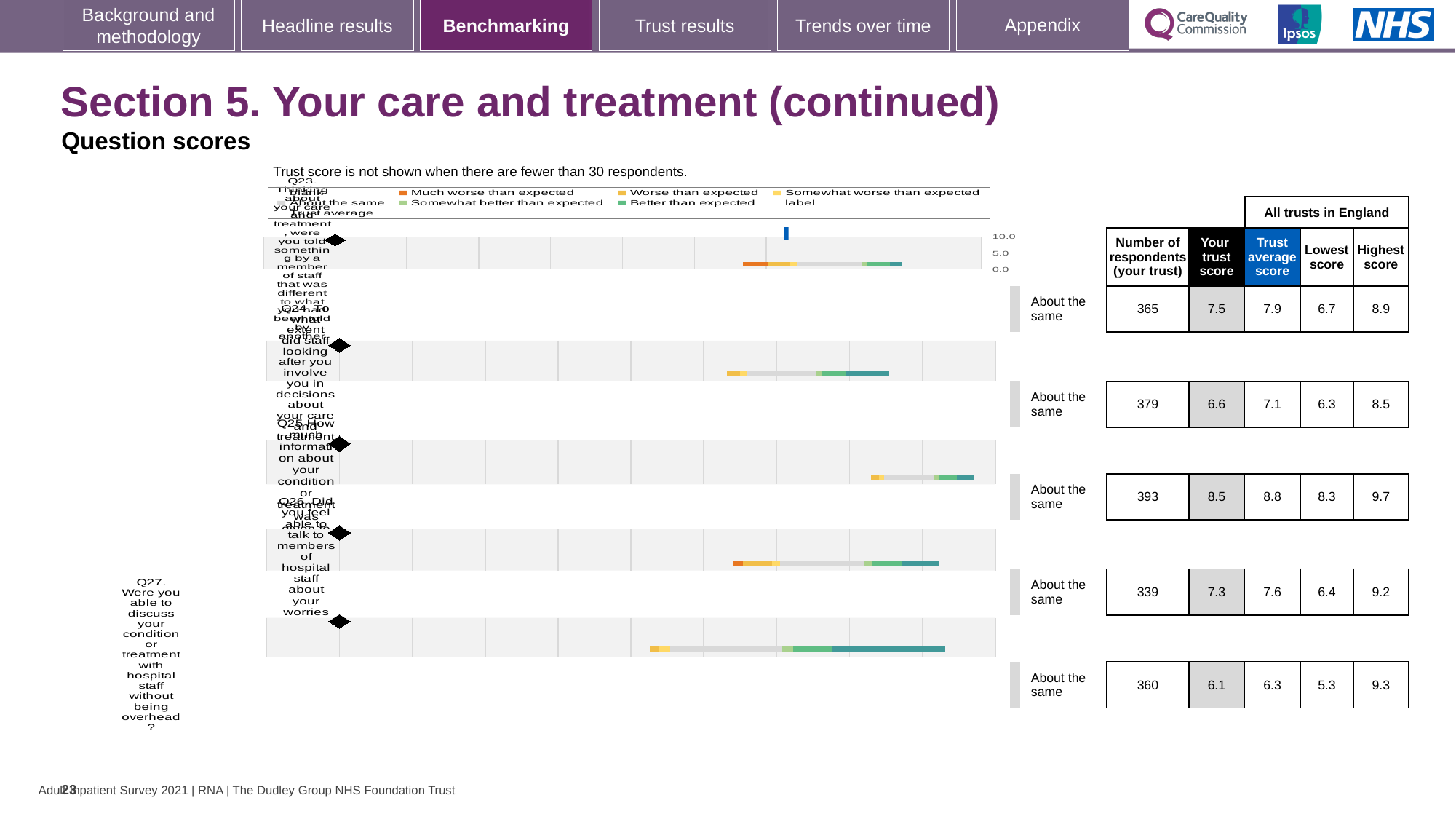
What comparison label is shown next to the Q23 bar? About the same Which question has the highest 'Your trust score'? Q25 For Q23, what is the difference between the trust average score and your trust score? 0.4 What is the lowest score across all trusts in England for Q27? 5.3 What is the 'Your trust score' for Q23? 7.5 What kind of chart is used to show the question scores on this slide? bar chart For Q24, which is larger: your trust score or the trust average score? Trust average score Which question has the lowest 'Your trust score'? Q27 What is the trust average score for Q26? 7.6 How many respondents (your trust) are shown for Q24? 379 What is the highest score across all trusts in England for Q25? 9.7 How many questions (Q23 to Q27) are plotted in the chart? 5